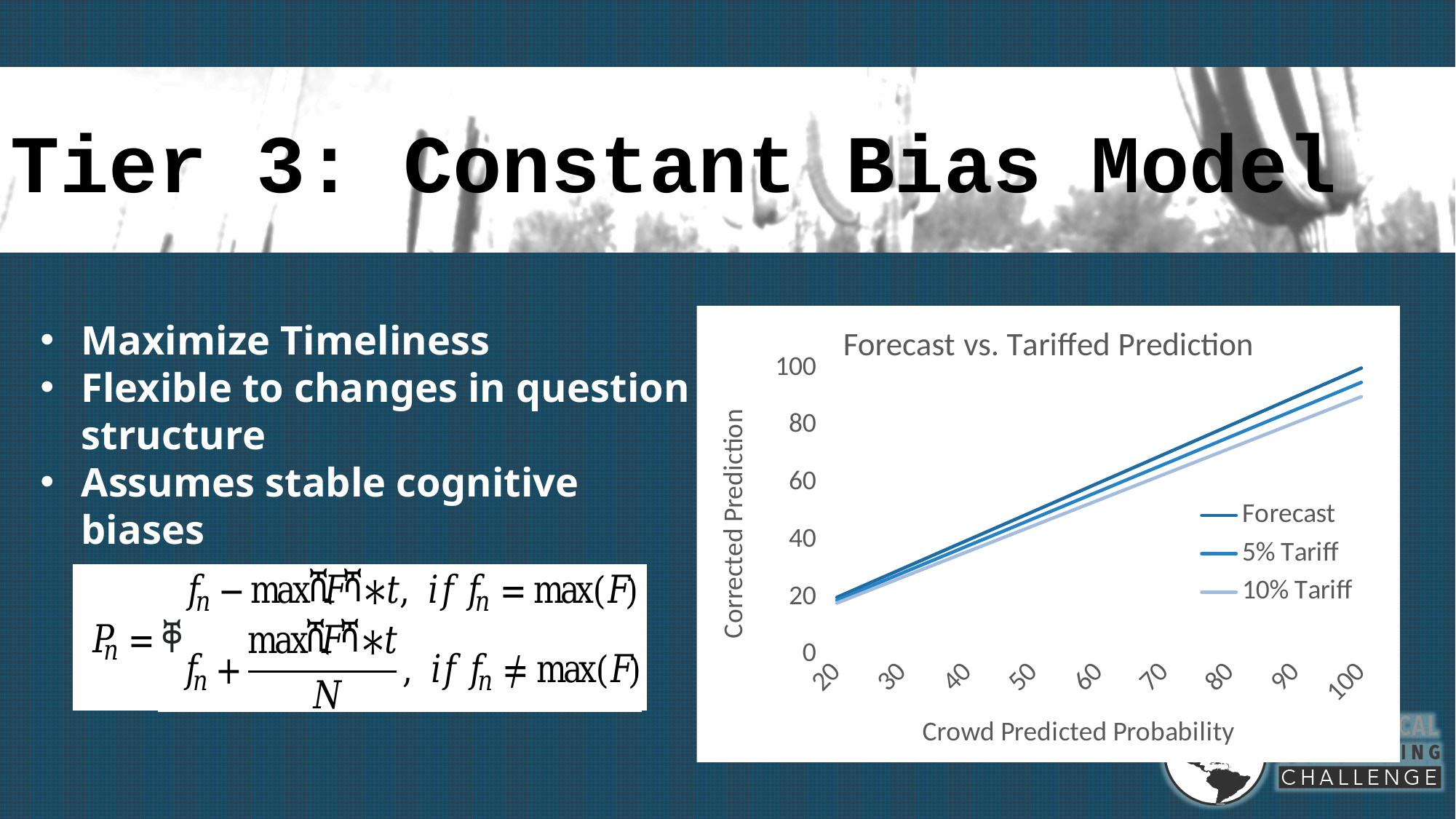
Which series has the highest Corrected Prediction at a Crowd Predicted Probability of 100? Forecast Is the Forecast value at a Crowd Predicted Probability of 100 greater or less than 80? greater Do the lines in the chart rise or fall as Crowd Predicted Probability increases? rise Is the 5% Tariff value at a Crowd Predicted Probability of 60 greater or less than 80? less At a Crowd Predicted Probability of 100, is the Forecast value larger or the 10% Tariff value larger? Forecast What kind of chart is shown on the slide? line chart Is the 10% Tariff value at a Crowd Predicted Probability of 20 greater or less than 40? less Which series has the lowest Corrected Prediction at a Crowd Predicted Probability of 100? 10% Tariff What is the label of the y axis of the chart? Corrected Prediction How many tick labels are shown on the x axis of the chart? 9 How many series does the legend of the chart list? 3 What is the title of the chart? Forecast vs. Tariffed Prediction